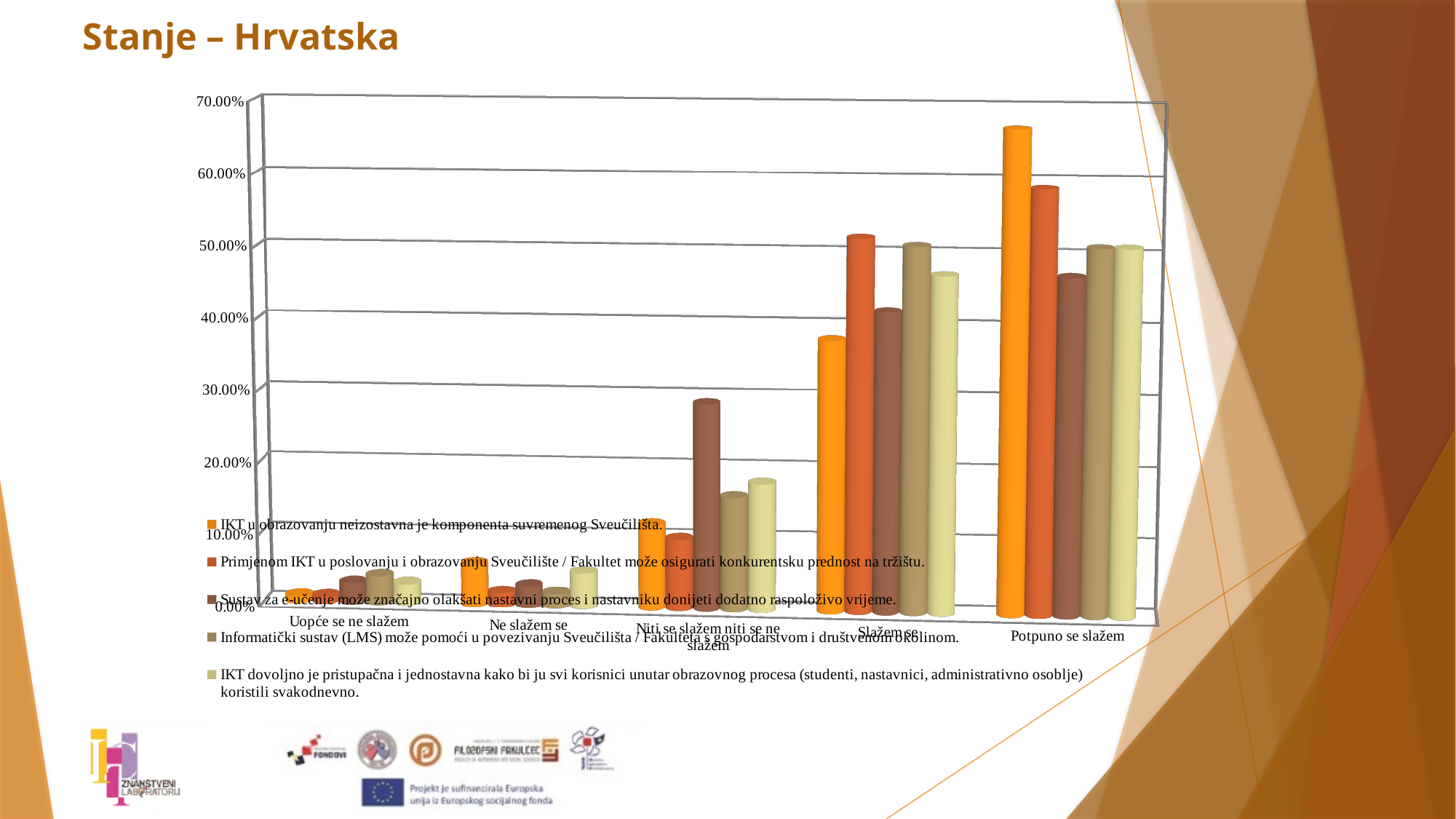
How many series does the chart's legend list? 5 Is the value for 'Niti se slažem niti se ne slažem' in the series 'Sustav za e-učenje može značajno olakšati nastavni proces i nastavniku donijeti dodatno raspoloživo vrijeme.' greater or less than 20.00%? greater Is the value for 'Potpuno se slažem' in the series 'Primjenom IKT u poslovanju i obrazovanju Sveučilište / Fakultet može osigurati konkurentsku prednost na tržištu.' greater or less than 50.00%? greater What kind of chart is shown on the slide? Bar chart How many categories are shown on the x axis of the chart? 5 Is the value for 'Slažem se' in the series 'IKT u obrazovanju neizostavna je komponenta suvremenog Sveučilišta.' greater or less than 40.00%? less Which category has the lowest value for the series 'IKT u obrazovanju neizostavna je komponenta suvremenog Sveučilišta.'? Uopće se ne slažem Do the values for the series 'IKT u obrazovanju neizostavna je komponenta suvremenog Sveučilišta.' rise or fall from 'Uopće se ne slažem' to 'Potpuno se slažem'? rise Which category has the highest value for the series 'IKT u obrazovanju neizostavna je komponenta suvremenog Sveučilišta.'? Potpuno se slažem In the category 'Slažem se', which is larger: the value for 'IKT u obrazovanju neizostavna je komponenta suvremenog Sveučilišta.' or for 'Primjenom IKT u poslovanju i obrazovanju Sveučilište / Fakultet može osigurati konkurentsku prednost na tržištu.'? Primjenom IKT u poslovanju i obrazovanju Sveučilište / Fakultet može osigurati konkurentsku prednost na tržištu. Which series has the highest value in the category 'Niti se slažem niti se ne slažem'? Sustav za e-učenje može značajno olakšati nastavni proces i nastavniku donijeti dodatno raspoloživo vrijeme.